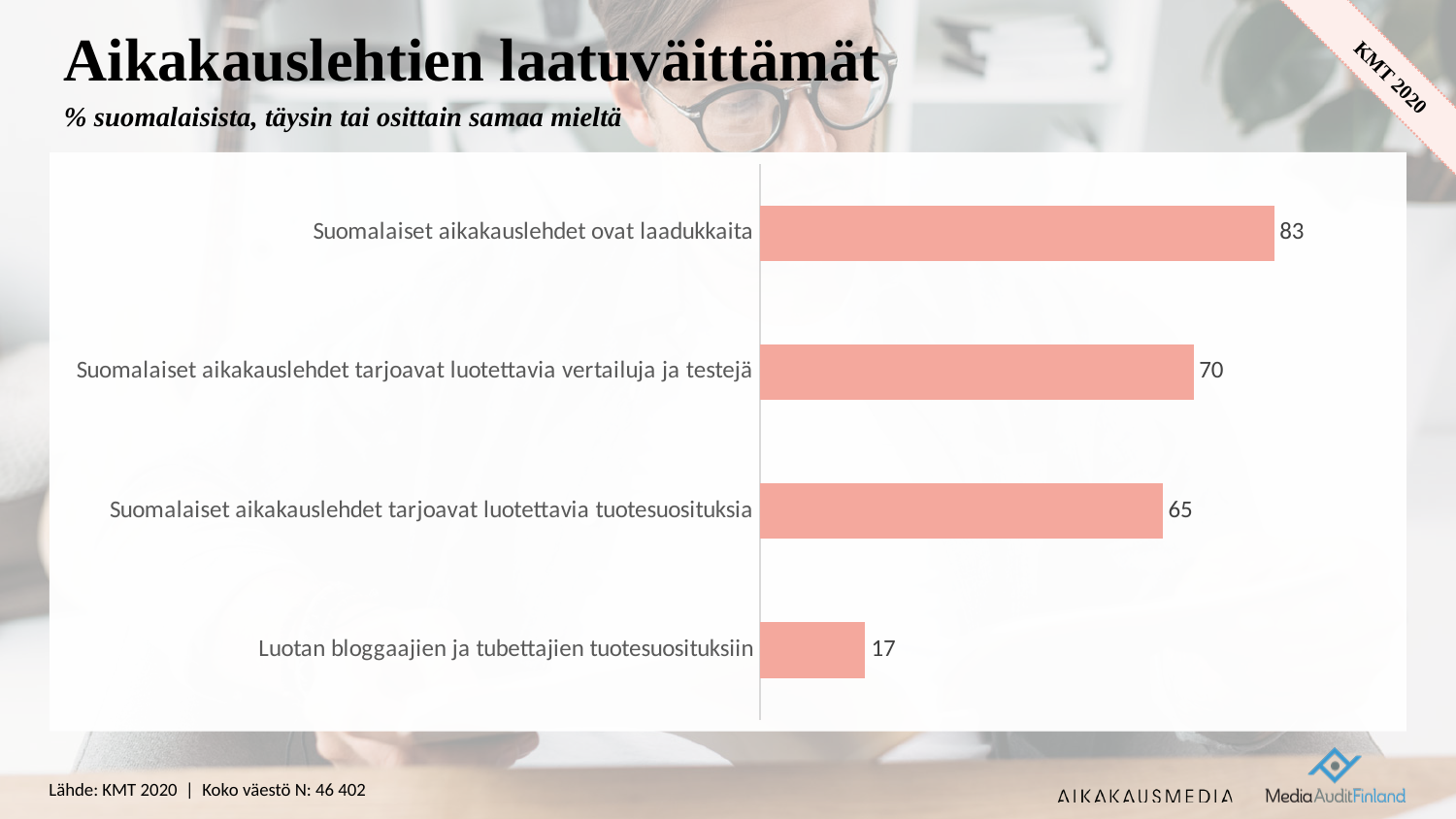
What is the difference between the values for "Suomalaiset aikakauslehdet ovat laadukkaita" and "Luotan bloggaajien ja tubettajien tuotesuosituksiin"? 66 How many categories are shown in the chart? 4 What is the value for "Suomalaiset aikakauslehdet tarjoavat luotettavia tuotesuosituksia"? 65 What is the title of the slide? Aikakauslehtien laatuväittämät Which category has the highest value? Suomalaiset aikakauslehdet ovat laadukkaita Which is larger: the value for "Suomalaiset aikakauslehdet tarjoavat luotettavia vertailuja ja testejä" or for "Suomalaiset aikakauslehdet tarjoavat luotettavia tuotesuosituksia"? Suomalaiset aikakauslehdet tarjoavat luotettavia vertailuja ja testejä Which category has the lowest value? Luotan bloggaajien ja tubettajien tuotesuosituksiin What is the value for "Luotan bloggaajien ja tubettajien tuotesuosituksiin"? 17 What is the value for "Suomalaiset aikakauslehdet tarjoavat luotettavia vertailuja ja testejä"? 70 What kind of chart is shown on the slide? Bar chart What is the value for "Suomalaiset aikakauslehdet ovat laadukkaita"? 83 What is the difference between the values for "Suomalaiset aikakauslehdet tarjoavat luotettavia vertailuja ja testejä" and "Suomalaiset aikakauslehdet tarjoavat luotettavia tuotesuosituksia"? 5